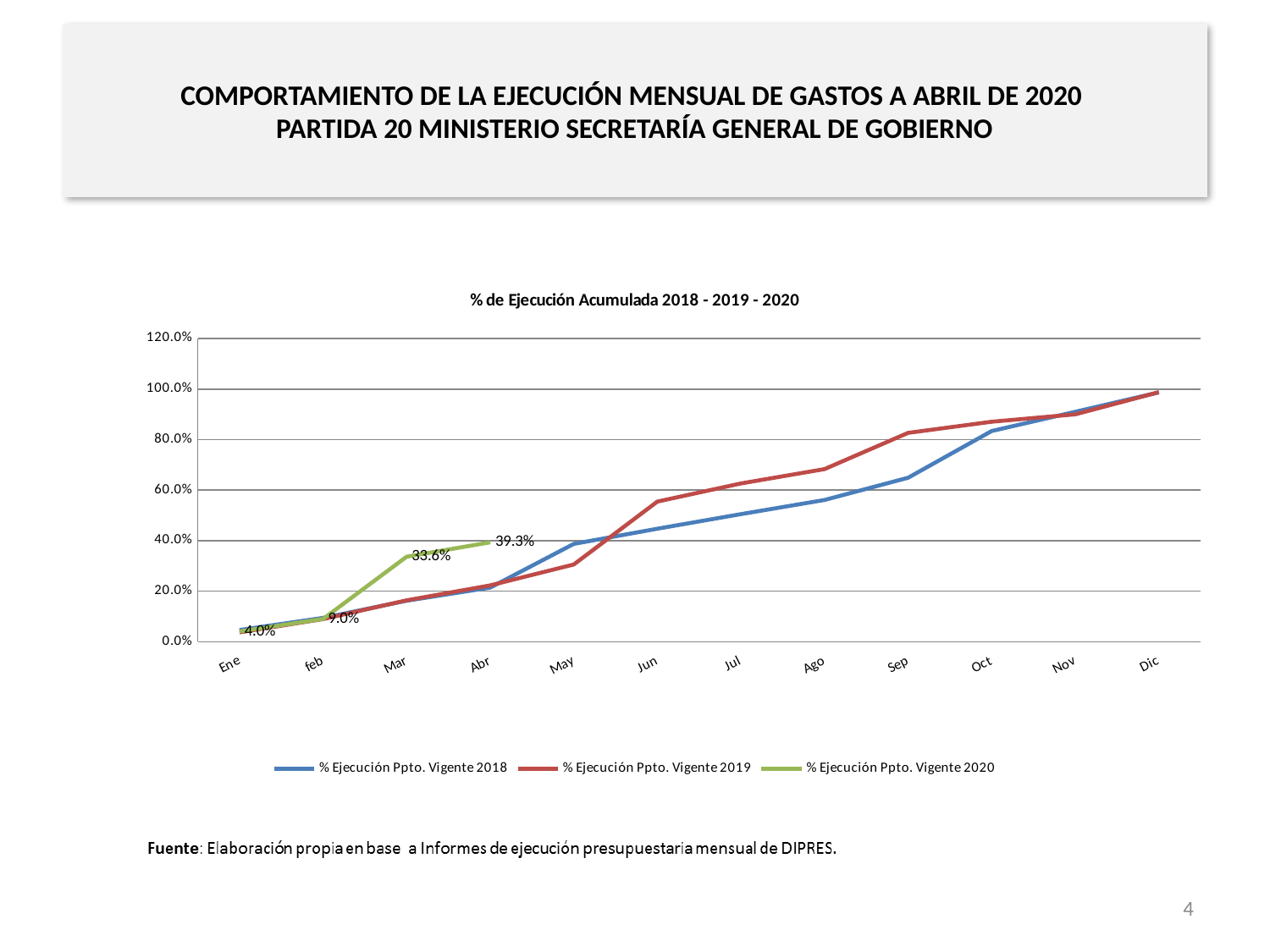
What is the value of % Ejecución Ppto. Vigente 2020 in Ene? 4.0% By how many percentage points did % Ejecución Ppto. Vigente 2020 increase from feb to Mar? 24.6 How many series does the legend list? 3 By how many percentage points did % Ejecución Ppto. Vigente 2020 increase from Mar to Abr? 5.7 What is the title of the chart? % de Ejecución Acumulada 2018 - 2019 - 2020 How many months are shown on the x axis? 12 What is the value of % Ejecución Ppto. Vigente 2020 in Mar? 33.6% What is the value of % Ejecución Ppto. Vigente 2020 in Abr? 39.3% In Sep, which series is higher: % Ejecución Ppto. Vigente 2018 or % Ejecución Ppto. Vigente 2019? % Ejecución Ppto. Vigente 2019 Is the value for % Ejecución Ppto. Vigente 2019 in Jun greater or less than 40.0%? greater What kind of chart is shown on the slide? Line chart What is the value of % Ejecución Ppto. Vigente 2020 in feb? 9.0%